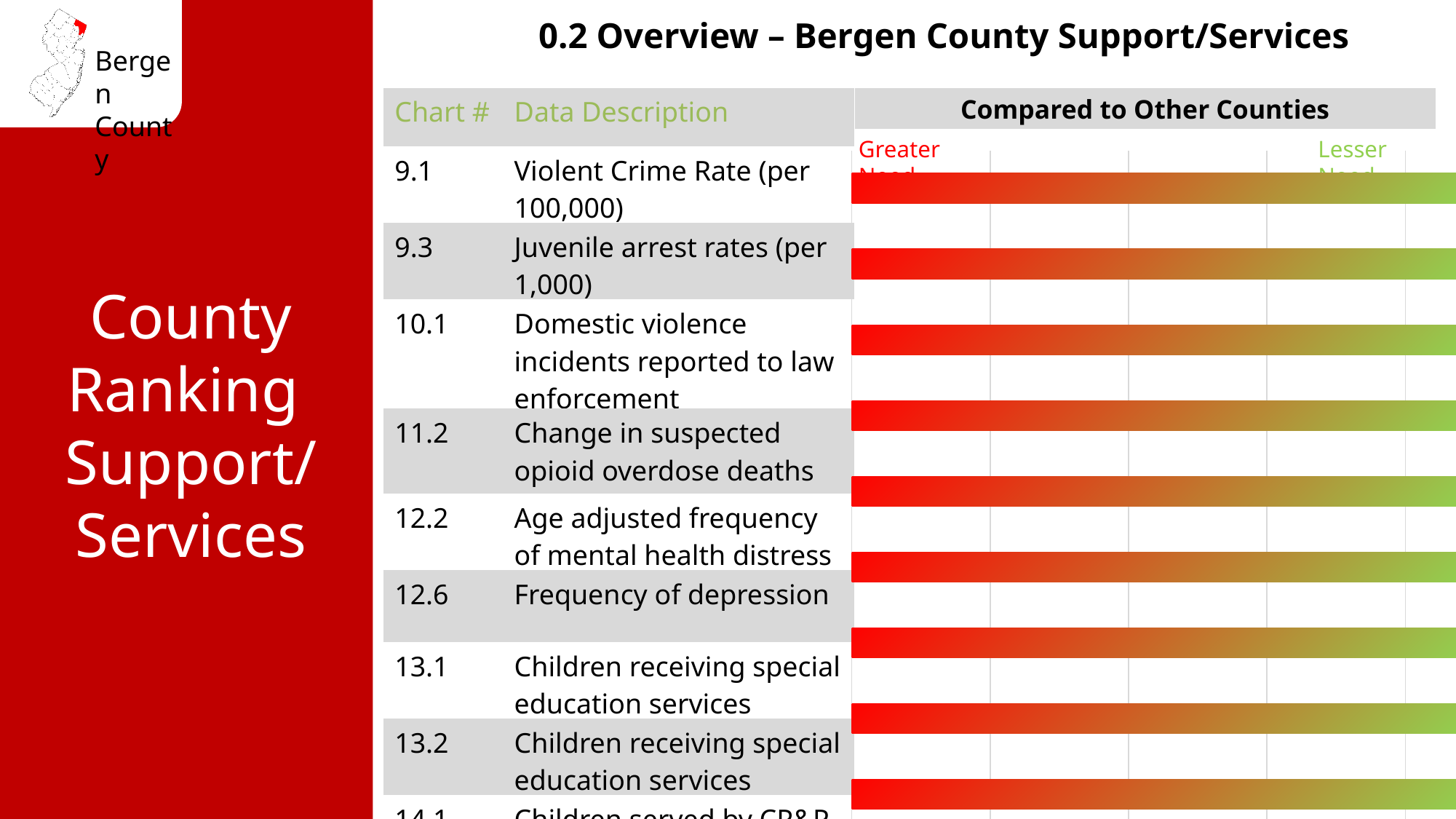
Which end of the bars in the chart is labelled 'Greater Need', the left or the right? left Which chart number in the table corresponds to 'Frequency of depression'? 12.6 How many horizontal bars are visible in the 'Compared to Other Counties' chart? 9 What is the title printed above the bar chart on the right side of the slide? Compared to Other Counties What kind of chart is shown under the heading 'Compared to Other Counties'? bar chart Which chart number in the table corresponds to 'Change in suspected opioid overdose deaths'? 11.2